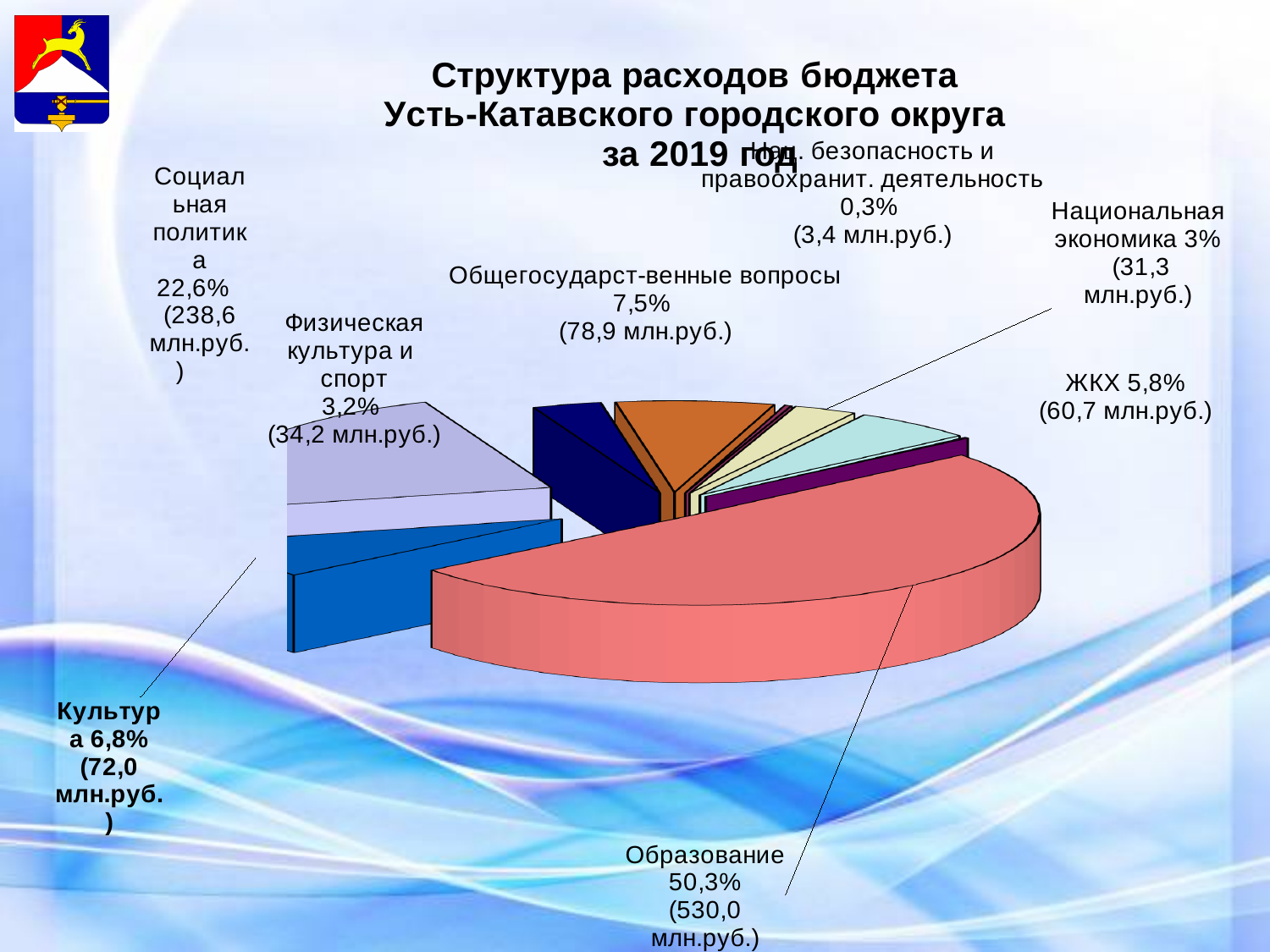
What share of the budget expenditure goes to Образование? 50,3% What is the amount in млн.руб. for Социальная политика? 238,6 млн.руб. What share of expenditure goes to ЖКХ? 5,8% What is the amount in млн.руб. for Общегосударственные вопросы? 78,9 млн.руб. What is the title of the chart? Структура расходов бюджета Усть-Катавского городского округа за 2019 год What is the amount in млн.руб. for Национальная экономика? 31,3 млн.руб. What is the difference in percentage points between the shares for Образование and Социальная политика? 27,7 What is the amount in млн.руб. for Культура? 72,0 млн.руб. What kind of chart is shown on the slide? pie chart Which category has the largest share of expenditure? Образование Which is larger, the share for Физическая культура и спорт or the share for Национальная экономика? Физическая культура и спорт